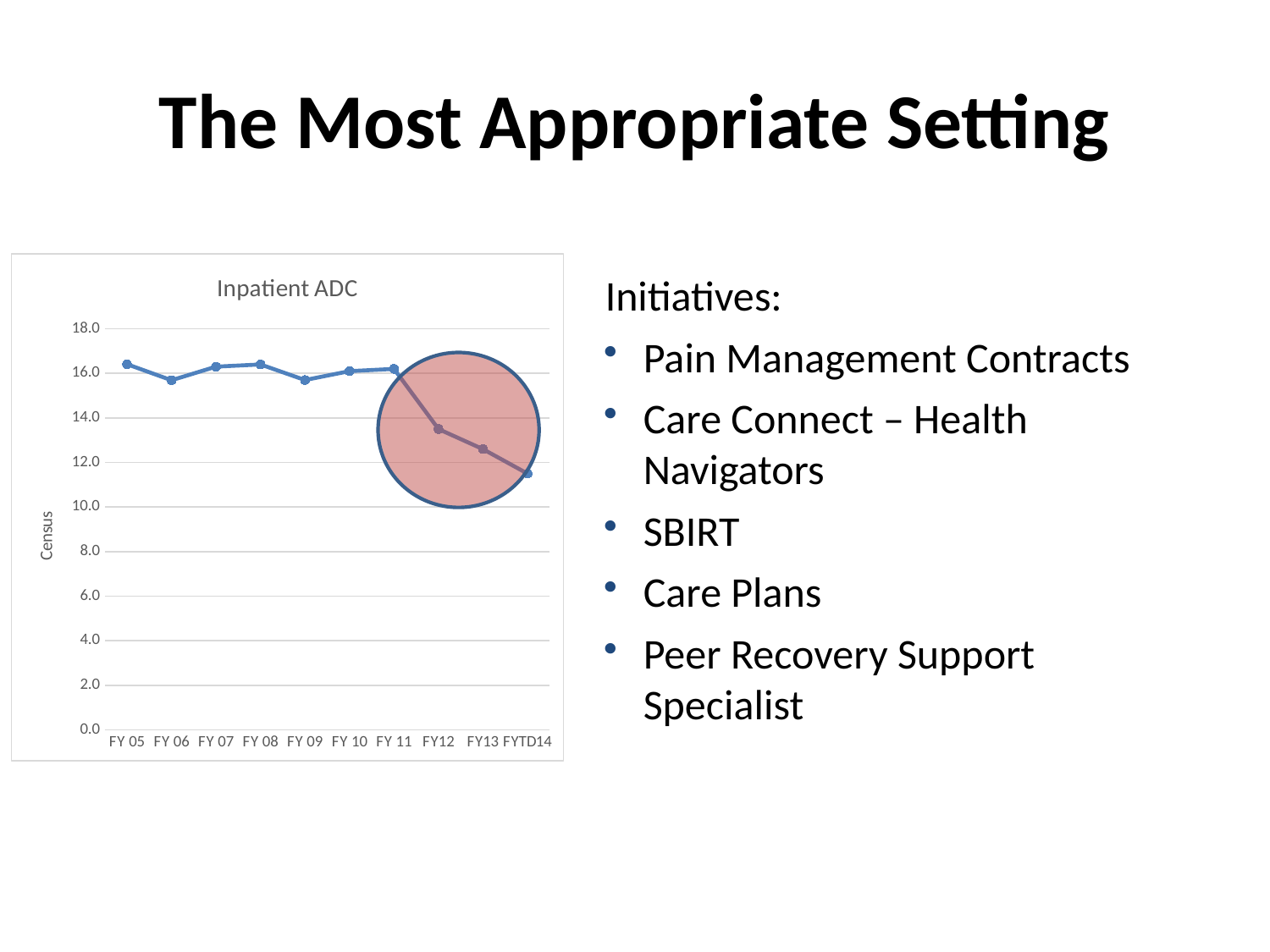
Which fiscal year has the lowest Inpatient ADC value? FYTD14 What kind of chart is shown on the slide? line chart Is the Inpatient ADC value for FY13 greater or less than 14.0? less Which is larger, the Inpatient ADC value for FY 05 or for FYTD14? FY 05 What is the title of the chart? Inpatient ADC Does the Inpatient ADC rise or fall from FY 11 to FYTD14? fall How many fiscal-year points are plotted on the x axis of the chart? 10 Is the Inpatient ADC value for FY12 greater or less than 16.0? less Which is larger, the Inpatient ADC value for FY 11 or for FY12? FY 11 Is the Inpatient ADC value for FYTD14 greater or less than 14.0? less What is the label on the vertical axis of the chart? Census